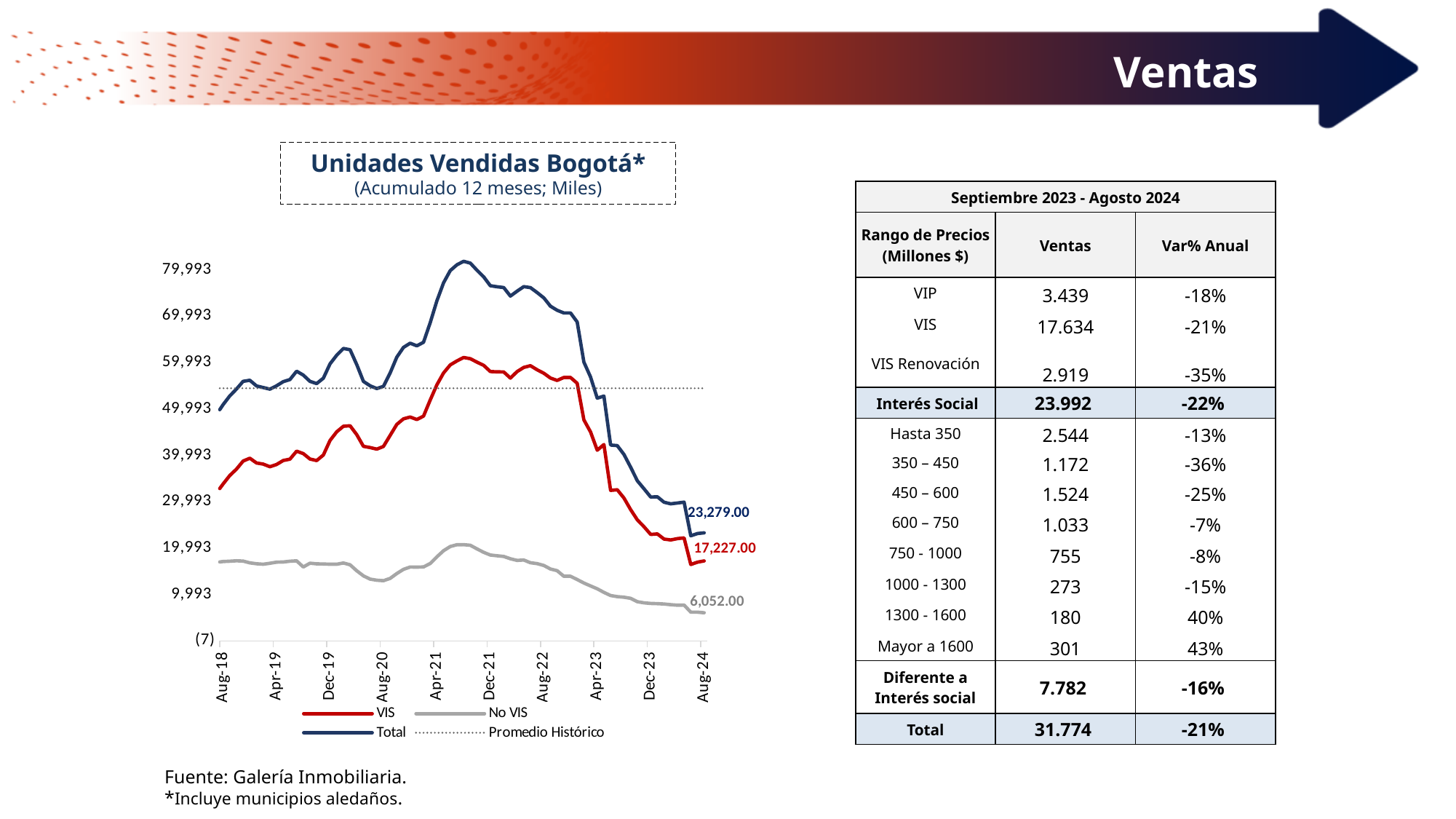
In the Unidades Vendidas Bogotá chart, what is the difference between the VIS and No VIS values at Aug-24? 11,175.00 In the Unidades Vendidas Bogotá chart, does the Total series rise or fall between Apr-23 and Aug-24? Fall In the Unidades Vendidas Bogotá chart, which is larger at Aug-24, VIS or No VIS? VIS What is the value of the VIS series at Aug-24 in the Unidades Vendidas Bogotá chart? 17,227.00 In the Unidades Vendidas Bogotá chart, what is the difference between the Total and VIS values at Aug-24? 6,052.00 What is the value of the Total series at Aug-24 in the Unidades Vendidas Bogotá chart? 23,279.00 How many series does the legend of the Unidades Vendidas Bogotá chart list? 4 What colour is the VIS line in the Unidades Vendidas Bogotá chart? Red Which series has the lowest value at Aug-24 in the Unidades Vendidas Bogotá chart? No VIS In the Unidades Vendidas Bogotá chart, is the VIS value at Aug-18 greater or less than 29,993? greater What is the value of the No VIS series at Aug-24 in the Unidades Vendidas Bogotá chart? 6,052.00 What kind of chart is the Unidades Vendidas Bogotá chart? Line chart